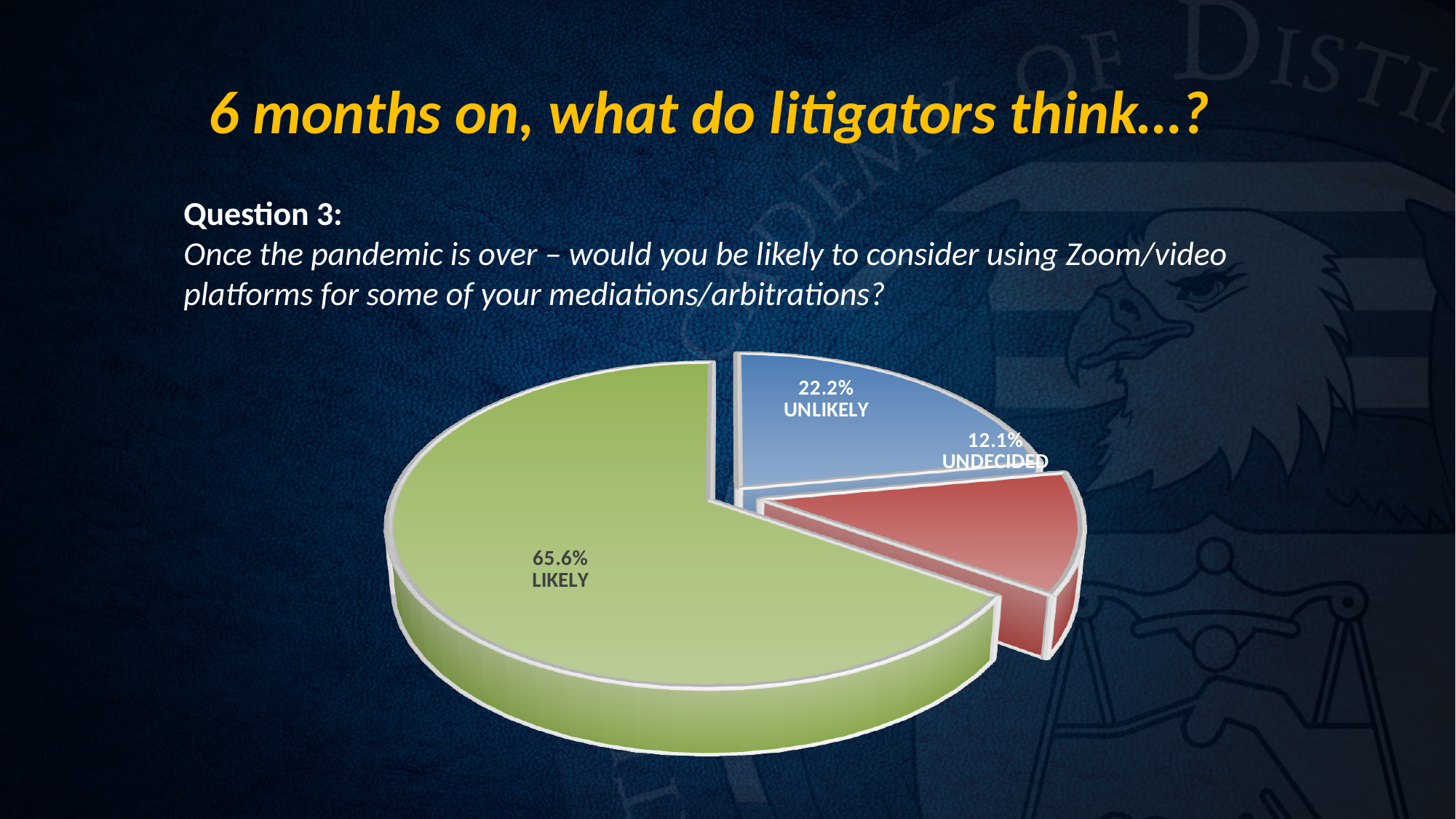
What percentage of litigators answered UNDECIDED? 12.1% What colour is the UNDECIDED slice of the pie chart? Red What kind of chart is shown on the slide? Pie chart What percentage of litigators answered UNLIKELY? 22.2% Which response has the largest share of the pie? LIKELY Which response has the smallest share of the pie? UNDECIDED What colour is the LIKELY slice of the pie chart? Green What is the difference in percentage points between UNLIKELY and UNDECIDED? 10.1 What percentage of litigators answered LIKELY? 65.6% What is the difference in percentage points between LIKELY and UNLIKELY? 43.4 How many slices does the pie chart have? 3 Which is larger, the UNLIKELY share or the UNDECIDED share? UNLIKELY